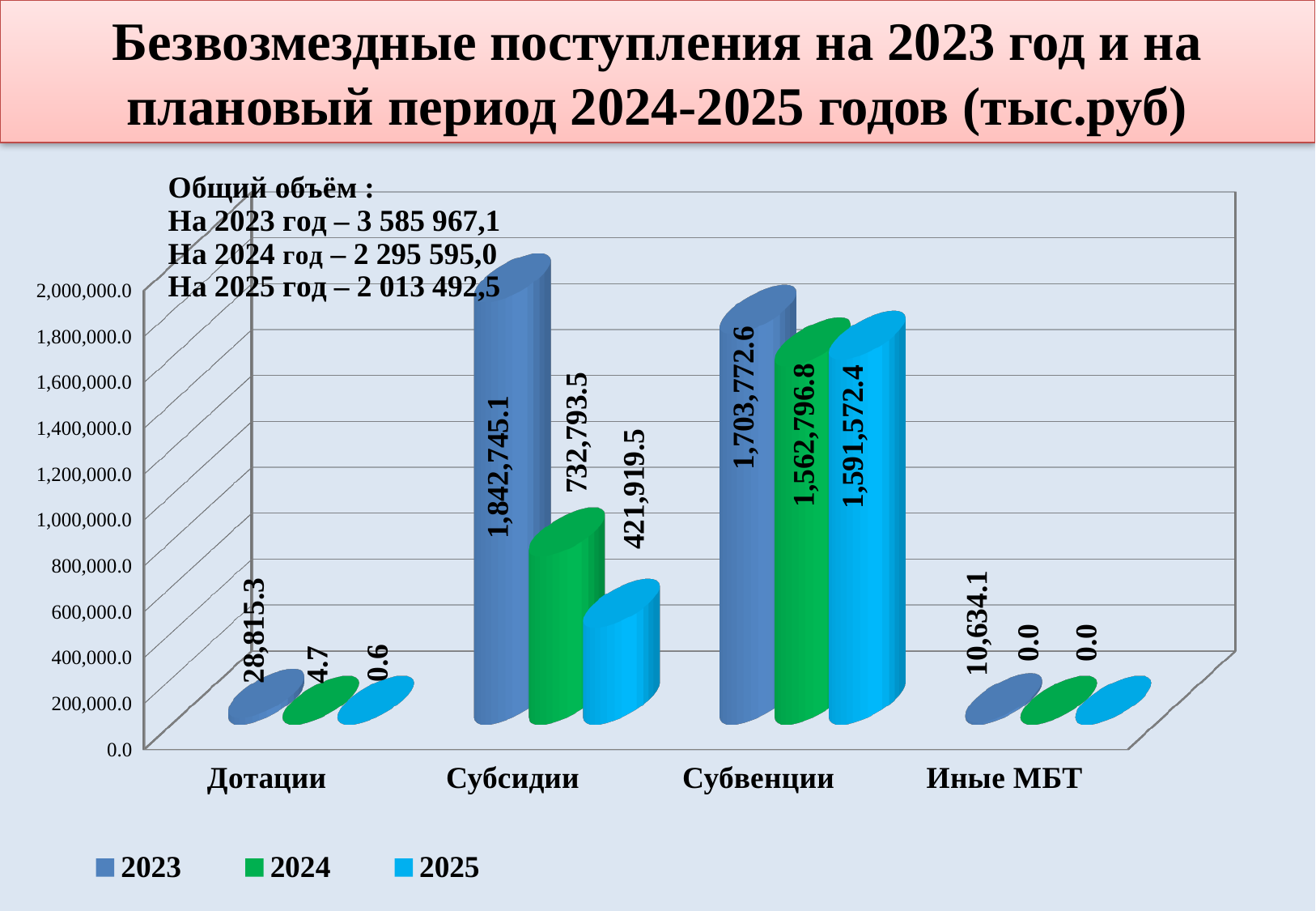
Which category has the lowest value for 2023? Иные МБТ What is the value for Субсидии in 2023? 1,842,745.1 Which is larger for 2024: Субсидии or Субвенции? Субвенции Do the values for Субсидии rise or fall from 2023 to 2025? fall What is the value for Иные МБТ in 2023? 10,634.1 What is the difference between the 2023 and 2024 values for Субсидии? 1,109,951.6 Is the value for Субсидии in 2025 greater or less than 600,000.0? less Which category has the highest value for 2023? Субсидии What is the value for Субвенции in 2025? 1,591,572.4 What is the value for Дотации in 2024? 4.7 How many series does the legend list? 3 How many categories are shown on the x axis? 4